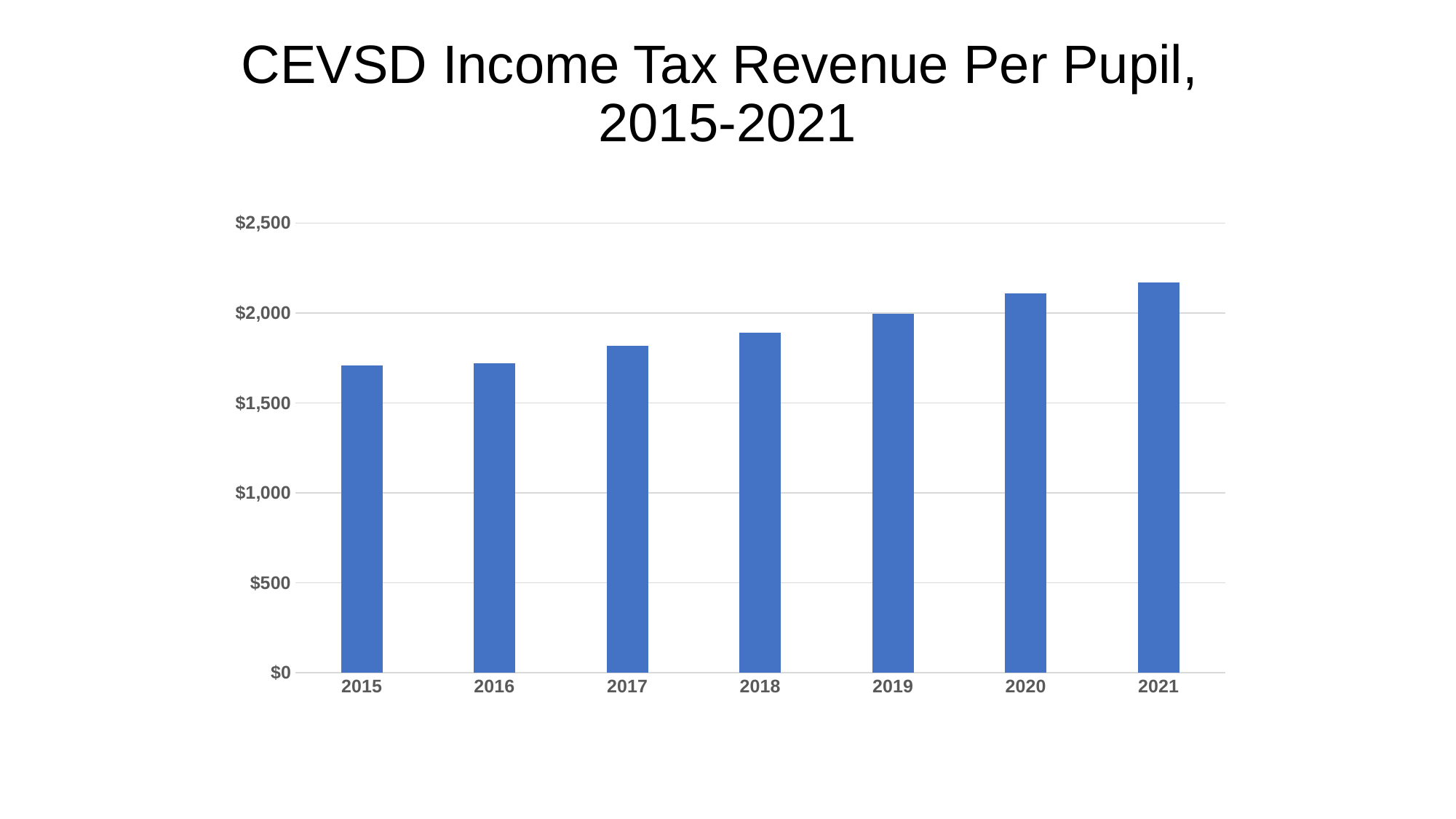
What kind of chart is shown on the slide? Bar chart Which year has the highest income tax revenue per pupil? 2021 Do the values generally rise or fall from 2015 to 2021? Rise How many years are plotted on the chart? 7 Which is larger, the value for 2021 or the value for 2015? 2021 Is the value for 2021 greater or less than $2,000? greater Is the value for 2020 greater or less than $2,000? greater What is the title of the chart? CEVSD Income Tax Revenue Per Pupil, 2015-2021 Is the value for 2018 greater or less than $2,000? less Which is larger, the value for 2018 or the value for 2020? 2020